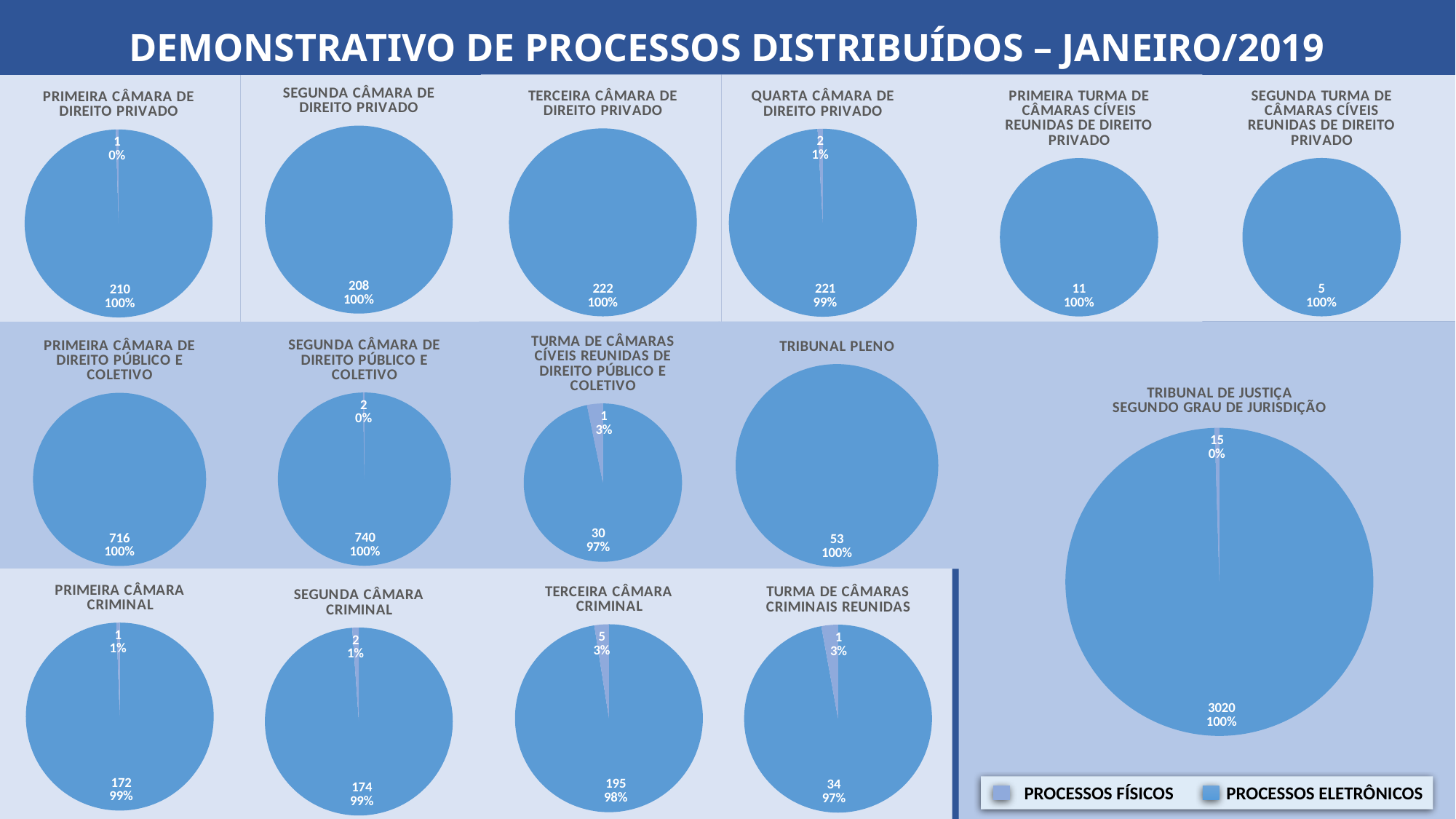
In the 'QUARTA CÂMARA DE DIREITO PRIVADO' chart, what is the difference between processos eletrônicos and processos físicos? 219 In the 'TRIBUNAL PLENO' chart, what is the value for processos eletrônicos? 53 In the 'TRIBUNAL DE JUSTIÇA SEGUNDO GRAU DE JURISDIÇÃO' chart, how many processos físicos are shown? 15 Which chart shows more processos eletrônicos: 'PRIMEIRA CÂMARA CRIMINAL' or 'SEGUNDA CÂMARA CRIMINAL'? SEGUNDA CÂMARA CRIMINAL How many series does the legend at the bottom right of the slide list? 2 In the 'TERCEIRA CÂMARA CRIMINAL' chart, what is the value for processos eletrônicos? 195 In the 'TERCEIRA CÂMARA CRIMINAL' chart, what share of the pie is processos físicos? 3% In the 'SEGUNDA CÂMARA DE DIREITO PÚBLICO E COLETIVO' chart, what is the value for processos eletrônicos? 740 What kind of chart is used for 'PRIMEIRA CÂMARA DE DIREITO PRIVADO'? Pie chart In the 'SEGUNDA TURMA DE CÂMARAS CÍVEIS REUNIDAS DE DIREITO PRIVADO' chart, what is the value for processos eletrônicos? 5 In the 'TURMA DE CÂMARAS CÍVEIS REUNIDAS DE DIREITO PÚBLICO E COLETIVO' chart, what share of the pie is processos eletrônicos? 97% In the 'TRIBUNAL DE JUSTIÇA SEGUNDO GRAU DE JURISDIÇÃO' chart, how many processos eletrônicos are shown? 3020